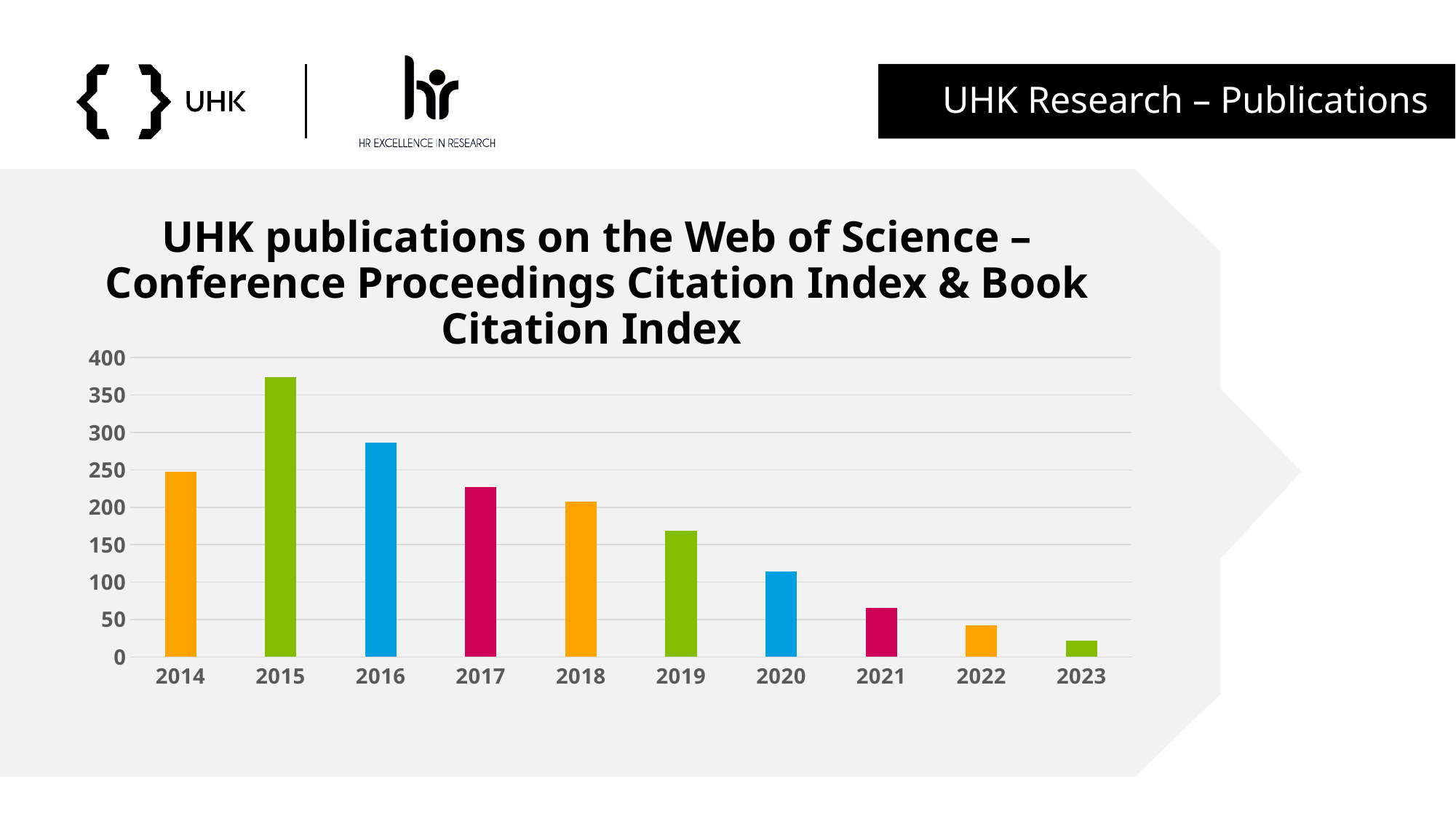
Is the value for 2022 greater or less than 50? less Is the value for 2015 greater or less than 350? greater Is the value for 2016 greater or less than 300? less Which is larger, the value for 2014 or the value for 2017? 2014 Which year has the lowest number of publications? 2023 How many years are shown on the x axis of the chart? 10 What kind of chart is shown on the slide? bar chart From 2015 to 2023, do the values rise or fall along the x axis? fall Which year has the highest number of publications? 2015 Which is larger, the value for 2019 or the value for 2021? 2019 What is the title of the chart? UHK publications on the Web of Science – Conference Proceedings Citation Index & Book Citation Index